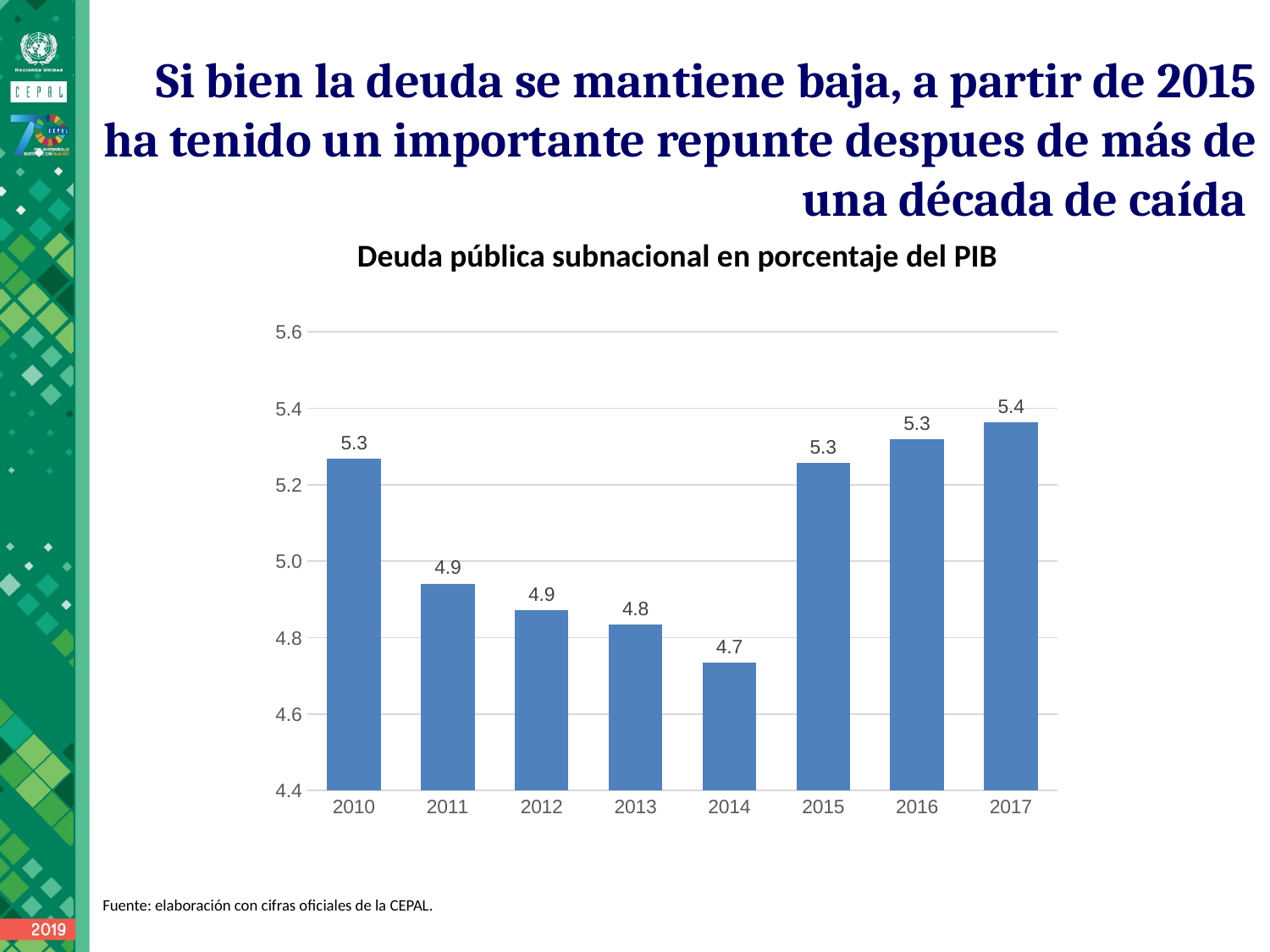
What is the difference between the values for 2017 and 2014? 0.7 What is the value for 2014? 4.7 Do the values rise or fall from 2014 to 2017? rise What kind of chart is shown on the slide? bar chart What is the value for 2017? 5.4 What is the title of the chart? Deuda pública subnacional en porcentaje del PIB Is the value for 2013 greater or less than 5.0? less How many years are shown on the x axis? 8 Which year has the lowest value? 2014 Which is larger, the value for 2010 or the value for 2011? 2010 What is the value for 2010? 5.3 Which year has the highest value? 2017